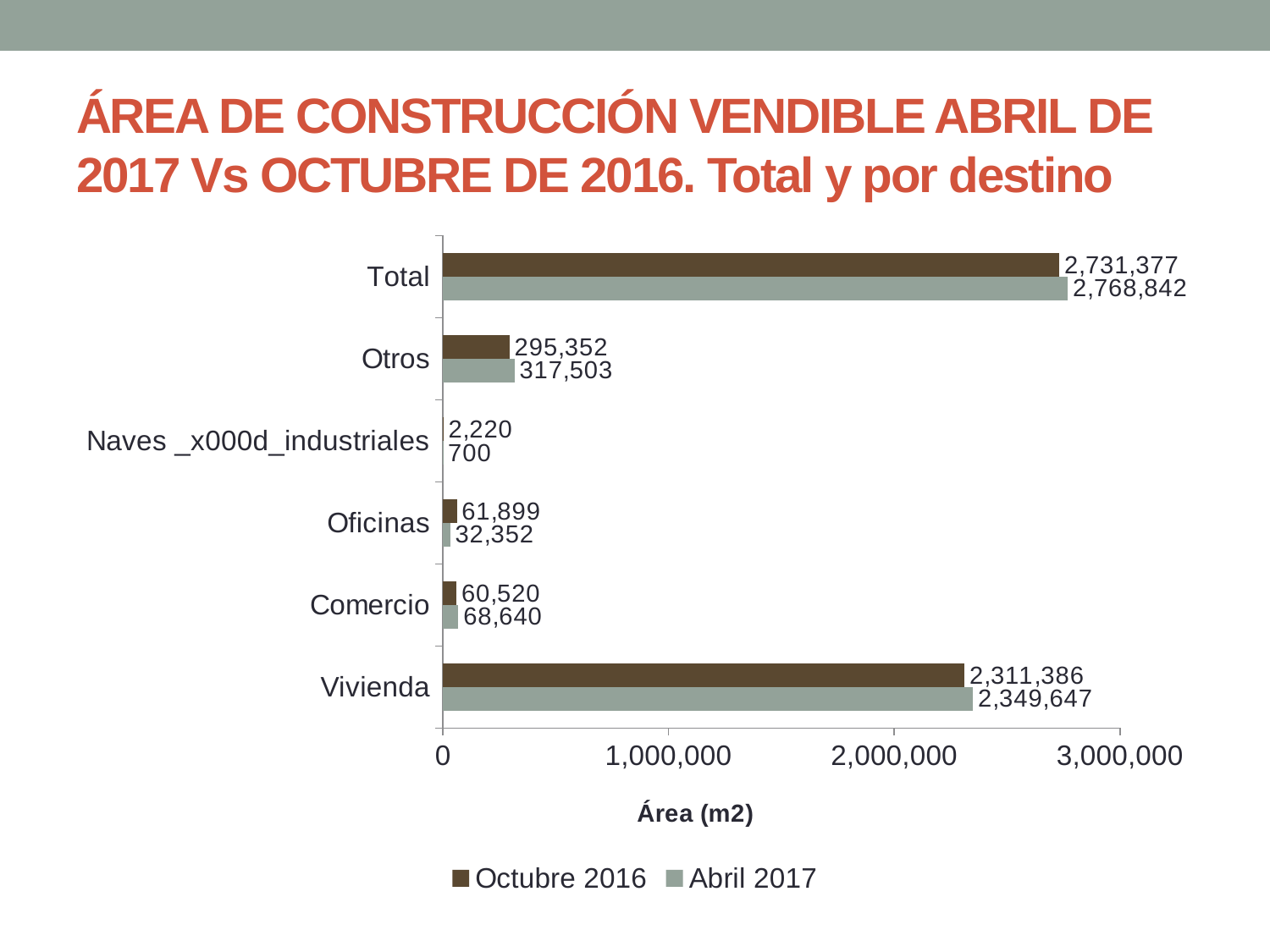
Excluding Total, which category has the highest Octubre 2016 value? Vivienda What is the Abril 2017 value for Total? 2,768,842 What is the difference between the Octubre 2016 and Abril 2017 values for Oficinas? 29,547 What is the Octubre 2016 value for Oficinas? 61,899 How many categories are shown on the chart? 6 What is the Octubre 2016 value for Vivienda? 2,311,386 For Comercio, which is larger: the Octubre 2016 value or the Abril 2017 value? Abril 2017 What is the difference between the Abril 2017 and Octubre 2016 values for Total? 37,465 What kind of chart is shown on the slide? Bar chart Which category has the lowest Abril 2017 value? Naves _x000d_industriales What is the Abril 2017 value for Otros? 317,503 How many series does the legend list? 2